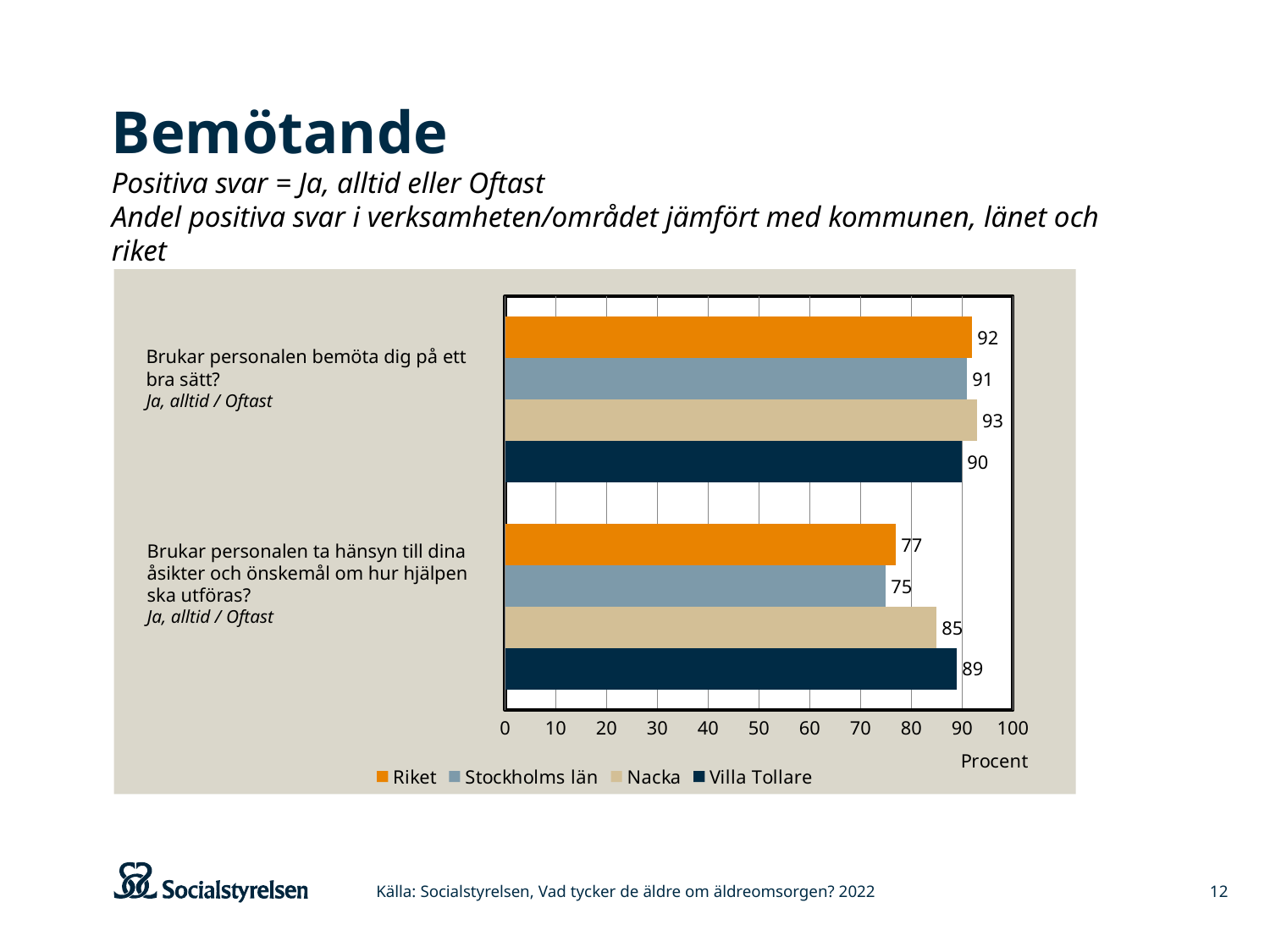
Which series has the lowest value for the question 'Brukar personalen ta hänsyn till dina åsikter och önskemål om hur hjälpen ska utföras?' Stockholms län How many series does the legend list? 4 How many questions (categories) are shown on the chart? 2 What value is shown for Riket on the question 'Brukar personalen ta hänsyn till dina åsikter och önskemål om hur hjälpen ska utföras?' 77 What is the label on the horizontal axis of the chart? Procent Which series has the highest value for the question 'Brukar personalen bemöta dig på ett bra sätt?' Nacka For the question 'Brukar personalen bemöta dig på ett bra sätt?', which is larger: the value for Riket or the value for Stockholms län? Riket What is the difference between the Villa Tollare and Stockholms län values for the question 'Brukar personalen ta hänsyn till dina åsikter och önskemål om hur hjälpen ska utföras?' 14 What value is shown for Nacka on the question 'Brukar personalen ta hänsyn till dina åsikter och önskemål om hur hjälpen ska utföras?' 85 What kind of chart is shown on the slide? bar chart Is the value for Stockholms län on the question 'Brukar personalen ta hänsyn till dina åsikter och önskemål om hur hjälpen ska utföras?' greater or less than 80? less What value is shown for Villa Tollare on the question 'Brukar personalen bemöta dig på ett bra sätt?' 90